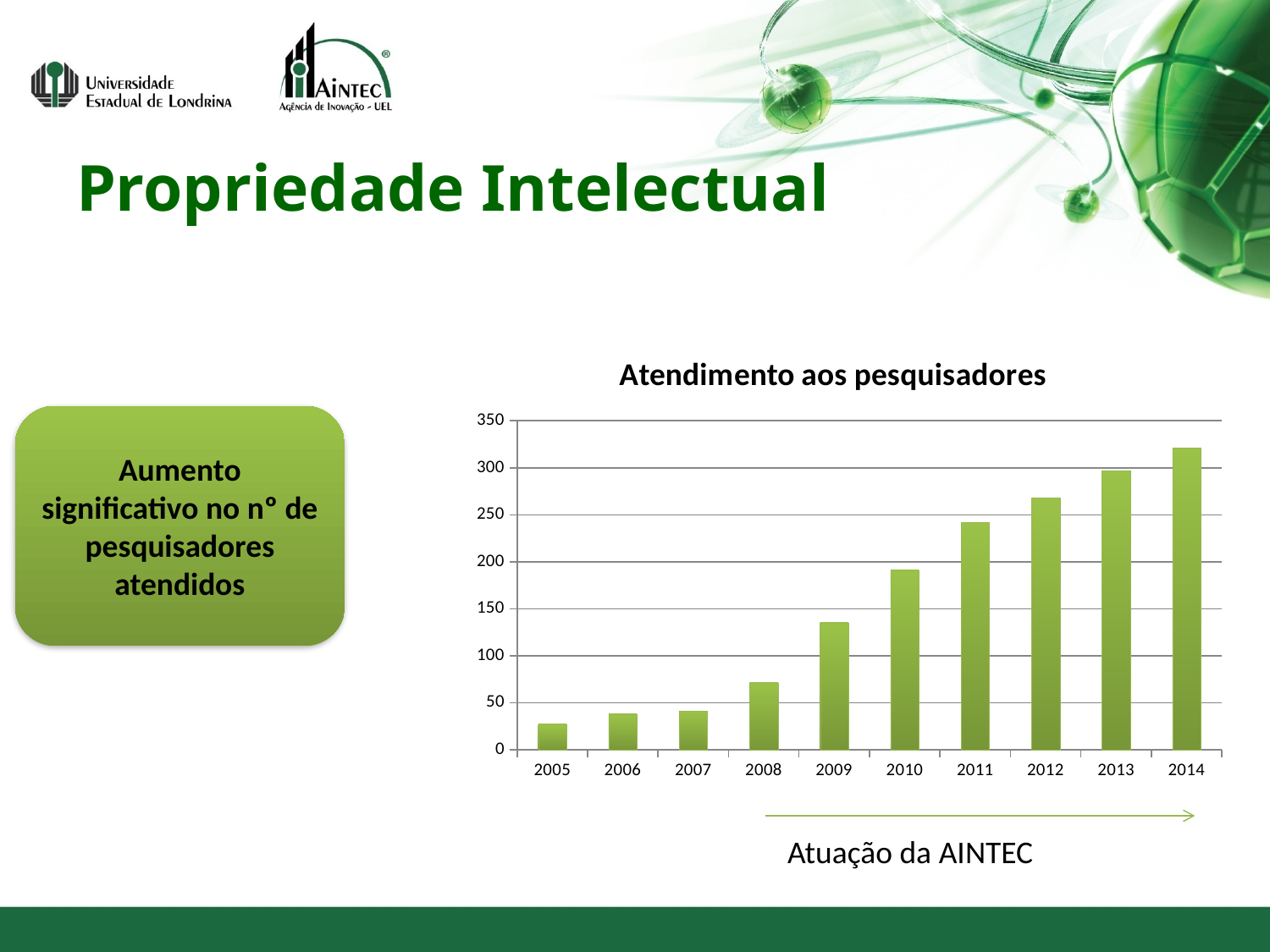
Is the value for 2014 greater or less than 300? greater Do the values rise or fall from 2005 to 2014? rise What is the title of the chart? Atendimento aos pesquisadores Is the value for 2005 greater or less than 50? less Is the value for 2012 greater or less than 250? greater Which is larger, the value for 2009 or the value for 2010? 2010 Which year has the lowest value in the chart? 2005 How many years are shown on the x axis of the chart? 10 What kind of chart is shown on the slide? bar chart Which year has the highest value in the chart? 2014